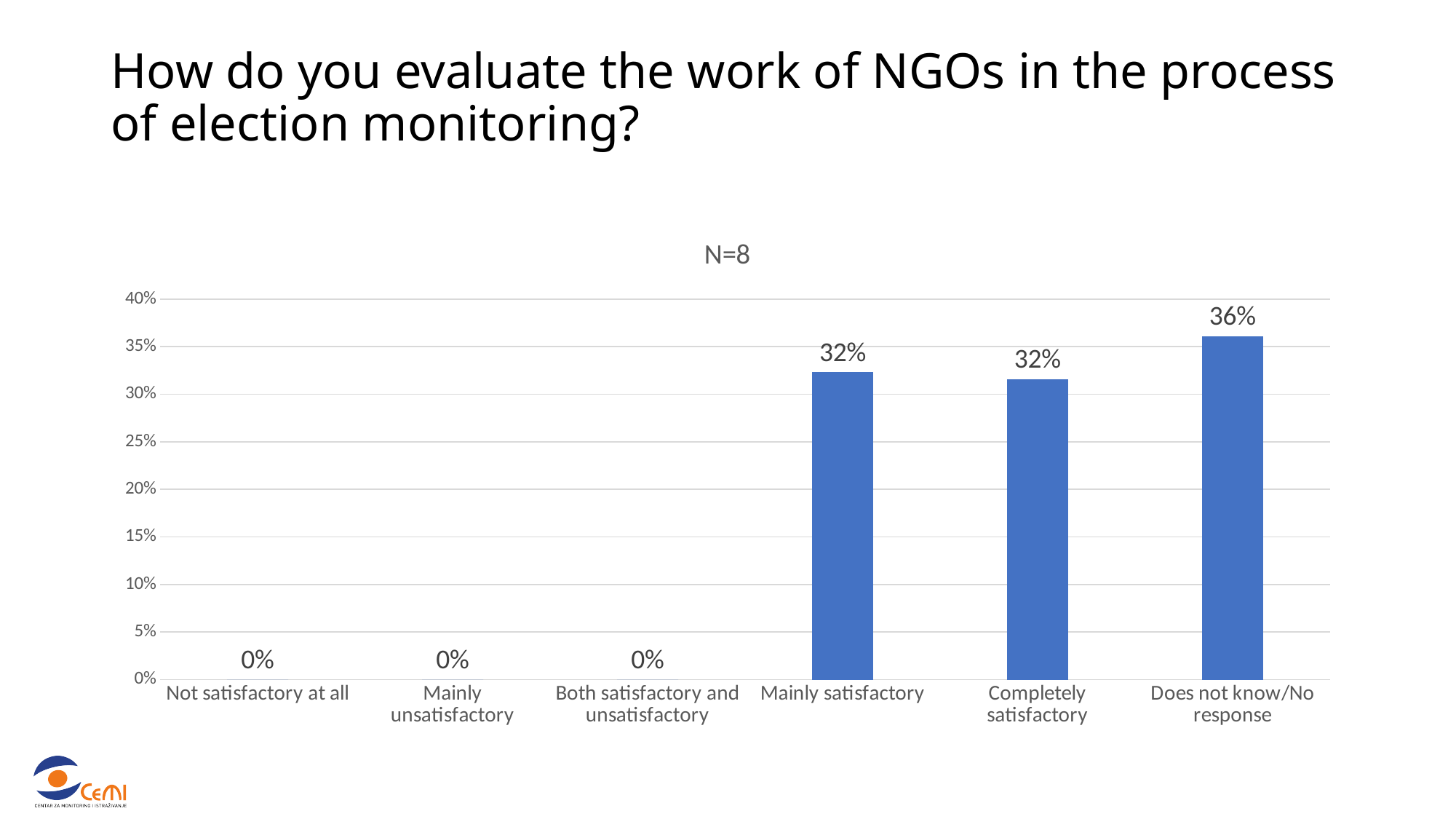
How many categories are shown on the x axis? 6 What is the value for Mainly satisfactory? 32% What is the value for Completely satisfactory? 32% What is the value for Does not know/No response? 36% Which category has the highest value? Does not know/No response Is the value for Mainly satisfactory greater or less than 20%? greater How many categories have a value of 0%? 3 What kind of chart is shown on the slide? bar chart What is the difference between Does not know/No response and Mainly satisfactory? 4% Which is larger, Does not know/No response or Completely satisfactory? Does not know/No response What is the value for Not satisfactory at all? 0% What is the title shown above the chart? N=8